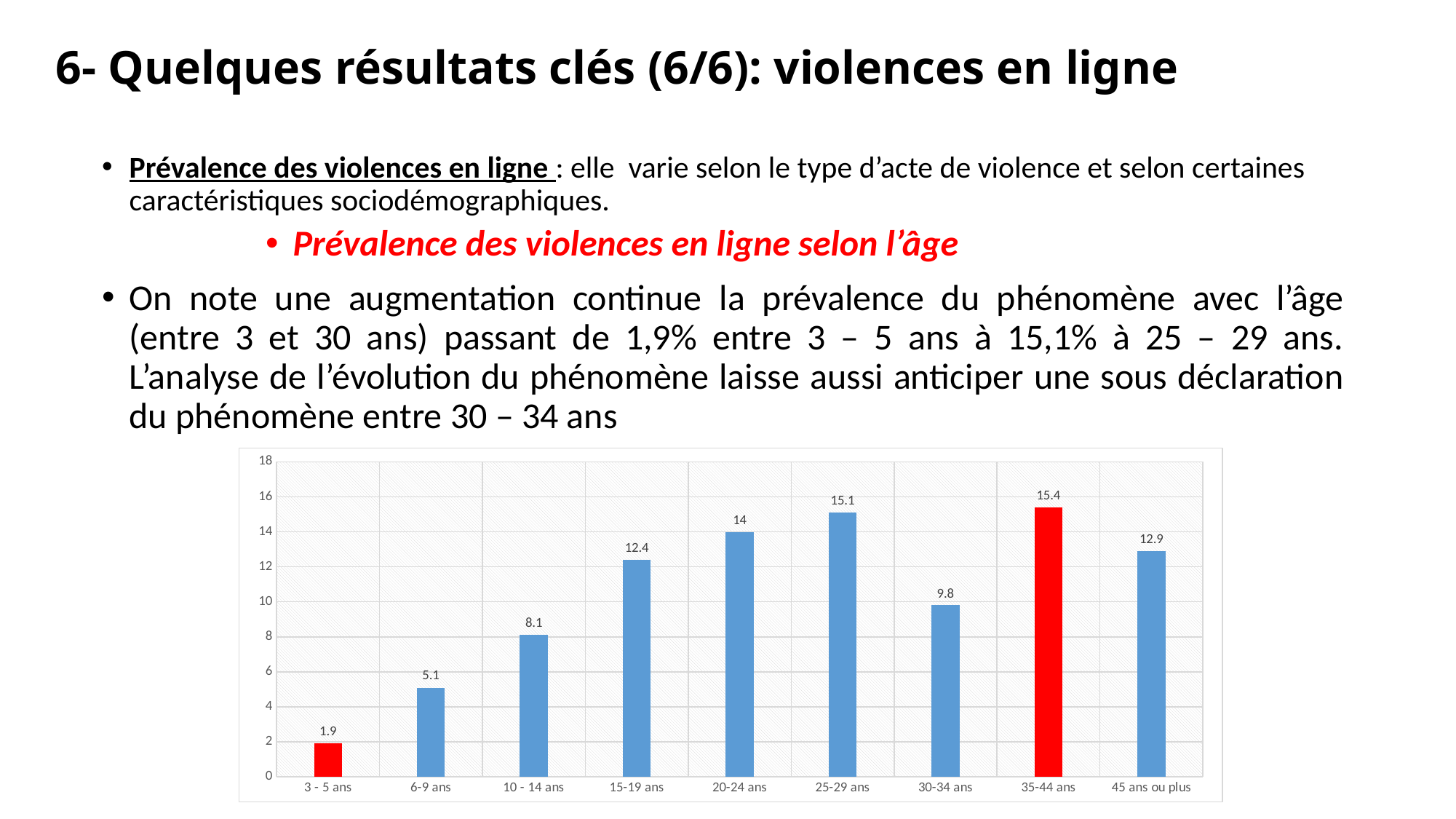
What is the value for the 25-29 ans age group? 15.1 Is the value for 10 - 14 ans greater or less than 10? less What is the value for the 3 - 5 ans age group? 1.9 How many age groups are shown on the x axis? 9 Which age group has the lowest value? 3 - 5 ans What is the value for the 45 ans ou plus age group? 12.9 What is the difference between the values for 25-29 ans and 30-34 ans? 5.3 Which two bars are coloured red? 3 - 5 ans and 35-44 ans Which is larger, the value for 15-19 ans or the value for 45 ans ou plus? 45 ans ou plus Which age group has the highest value? 35-44 ans Do the values rise or fall from 3 - 5 ans to 25-29 ans? rise What kind of chart is shown on the slide? bar chart